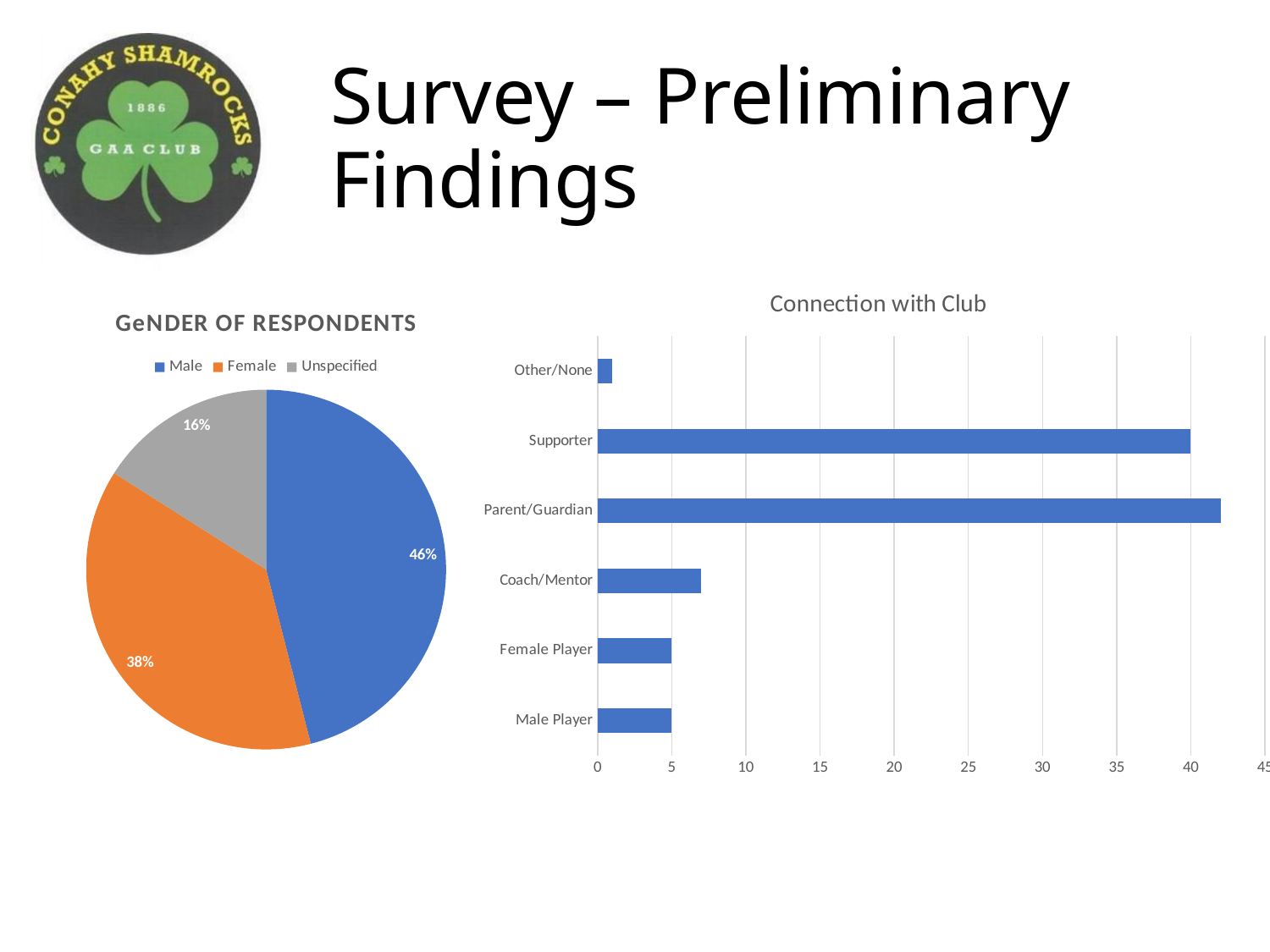
In the GeNDER OF RESPONDENTS pie chart, what is the difference in percentage points between Male and Female? 8% How many categories are shown in the Connection with Club chart? 6 In the Connection with Club chart, what is the value for Female Player? 5 In the GeNDER OF RESPONDENTS pie chart, what share of respondents are Unspecified? 16% What type of chart is the Connection with Club chart? Bar chart In the Connection with Club chart, what is the value for Supporter? 40 In the Connection with Club chart, which category has the highest value? Parent/Guardian In the Connection with Club chart, is the value for Parent/Guardian greater or less than 40? greater In the GeNDER OF RESPONDENTS pie chart, what percentage of respondents are Male? 46% In the Connection with Club chart, which category has the lowest value? Other/None In the GeNDER OF RESPONDENTS pie chart, which gender has the largest share? Male How many entries does the legend of the GeNDER OF RESPONDENTS chart list? 3